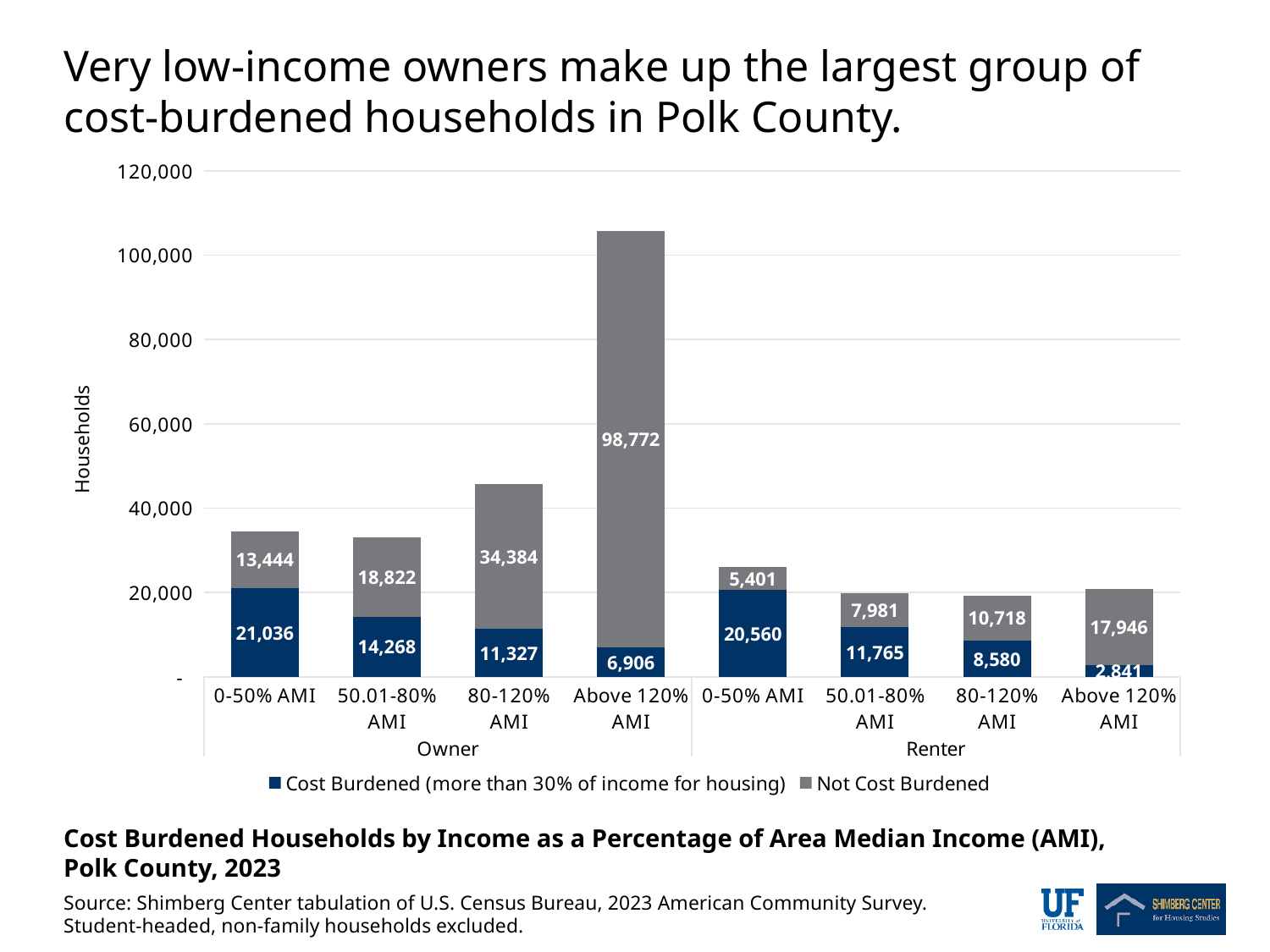
How many cost-burdened owner households are in the 0-50% AMI group? 21,036 What is the total number of households in the Renter 0-50% AMI bar? 25,961 How many income-group bars are shown in the chart? 8 What kind of chart is shown on the slide? Stacked bar chart Is the total height of the Owner Above 120% AMI bar greater or less than 100,000? greater How many series does the legend list? 2 Which category has the smallest number of cost-burdened households? Renter, Above 120% AMI How many not-cost-burdened renter households are in the Above 120% AMI group? 17,946 Which category has the largest number of not-cost-burdened households? Owner, Above 120% AMI What is the difference between cost-burdened owner households at 0-50% AMI and cost-burdened renter households at 0-50% AMI? 476 Which is larger: the number of cost-burdened owner households at 50.01-80% AMI or the number of cost-burdened renter households at 50.01-80% AMI? Owner, 50.01-80% AMI (14,268) How many cost-burdened renter households are in the 80-120% AMI group? 8,580